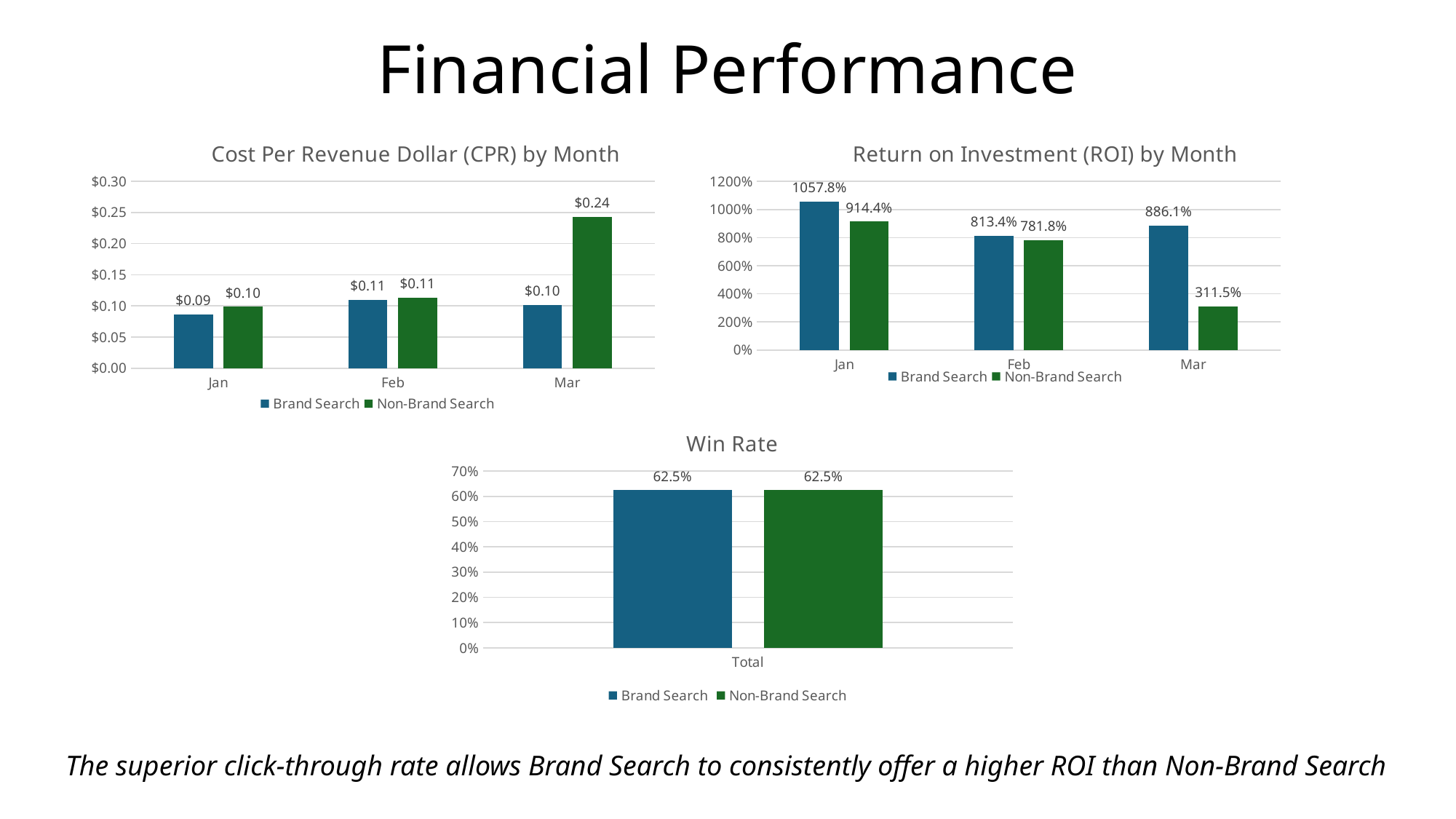
In the 'Return on Investment (ROI) by Month' chart, which is larger for Feb: Brand Search or Non-Brand Search? Brand Search What kind of chart is the 'Cost Per Revenue Dollar (CPR) by Month' chart? bar chart In the 'Cost Per Revenue Dollar (CPR) by Month' chart, what is the Non-Brand Search value for Mar? $0.24 In the 'Return on Investment (ROI) by Month' chart, does the Brand Search value fall or rise from Jan to Feb? fall In the 'Cost Per Revenue Dollar (CPR) by Month' chart, what is the Brand Search value for Jan? $0.09 In the 'Return on Investment (ROI) by Month' chart, what is the difference between the Brand Search and Non-Brand Search values for Mar? 574.6% In the 'Return on Investment (ROI) by Month' chart, which month has the lowest Non-Brand Search value? Mar In the 'Return on Investment (ROI) by Month' chart, what is the Non-Brand Search value for Mar? 311.5% In the 'Return on Investment (ROI) by Month' chart, what is the Brand Search value for Jan? 1057.8% In the 'Win Rate' chart, what is the Brand Search value for Total? 62.5% How many series does the legend of the 'Win Rate' chart list? 2 In the 'Cost Per Revenue Dollar (CPR) by Month' chart, which month has the highest Non-Brand Search value? Mar